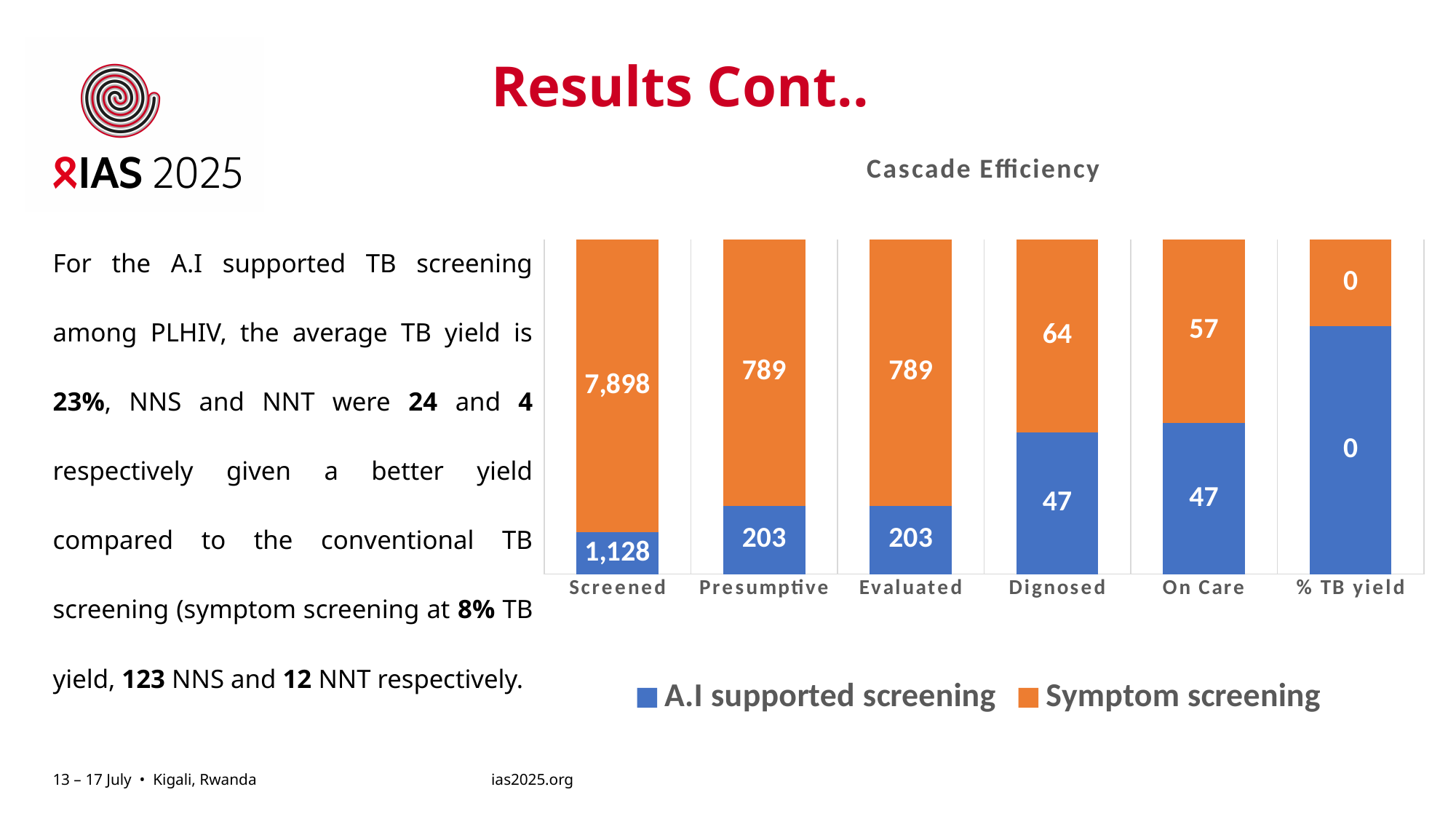
For Dignosed, which series has the larger value, A.I supported screening or Symptom screening? Symptom screening What kind of chart is the Cascade Efficiency chart? Stacked bar chart Which category has the highest A.I supported screening value? Screened What is the A.I supported screening value for On Care? 47 How many categories are shown on the x axis of the Cascade Efficiency chart? 6 What is the Symptom screening value for Screened? 7,898 What is the A.I supported screening value for Screened? 1,128 What is the difference between the Symptom screening values for Dignosed and On Care? 7 What is the A.I supported screening value for Evaluated? 203 How many series does the legend of the Cascade Efficiency chart list? 2 What is the Symptom screening value for Dignosed? 64 What is the difference between the Symptom screening and A.I supported screening values for Presumptive? 586